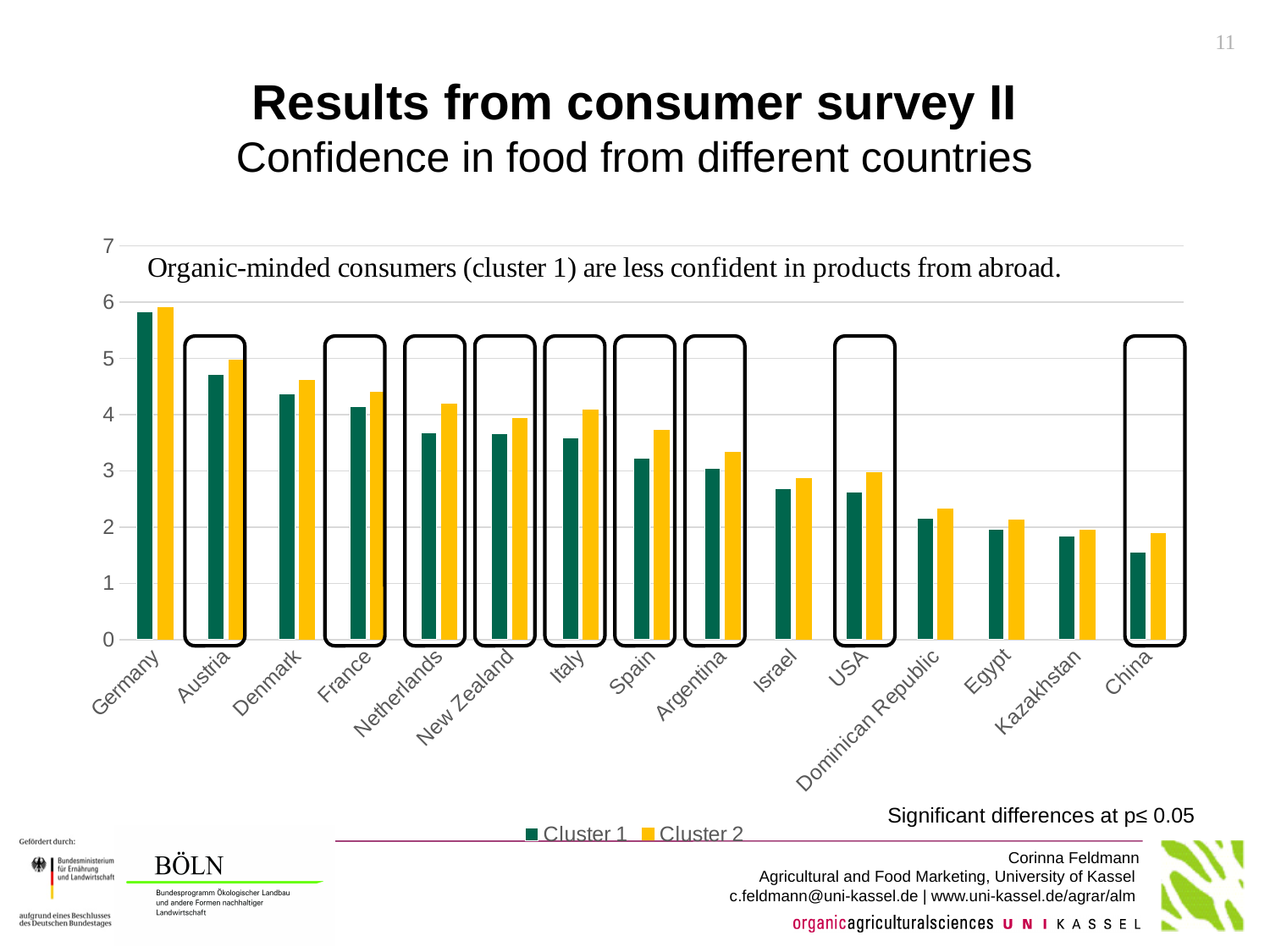
How many countries are shown on the x axis of the chart? 15 Is the Cluster 1 value for China greater or less than 2? less Is the Cluster 1 value for Israel greater or less than 3? less Which country has the highest Cluster 1 value? Germany What are the two series named in the chart's legend? Cluster 1 and Cluster 2 What kind of chart is shown on the slide? bar chart Is the Cluster 2 value for Netherlands greater or less than 4? greater Which country has the lowest Cluster 1 value? China Do the values generally rise or fall moving from Germany on the left to China on the right? fall For Netherlands, which series has the larger value, Cluster 1 or Cluster 2? Cluster 2 How many series does the chart's legend list? 2